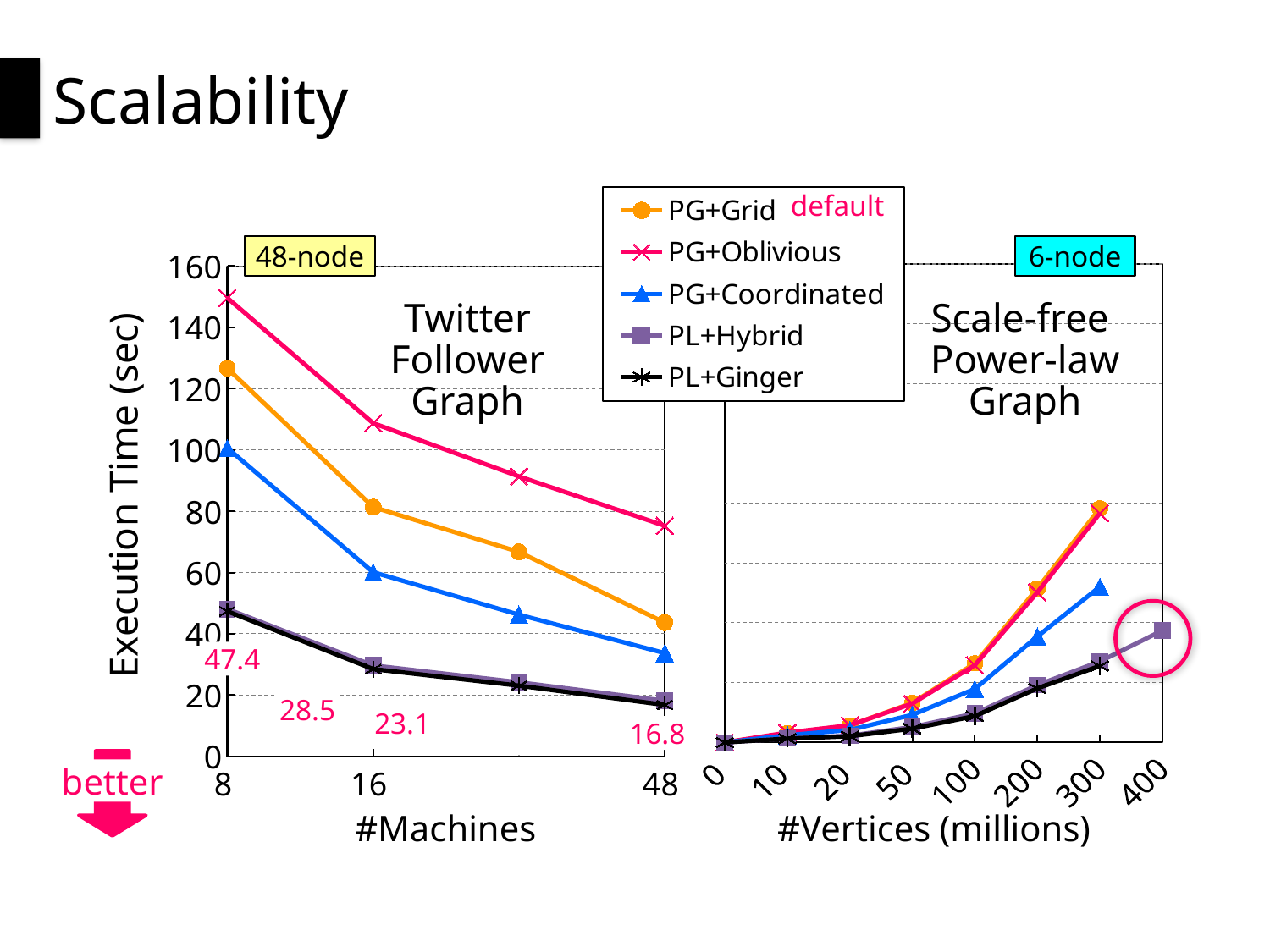
On the left chart (Twitter Follower Graph), is the value for PG+Oblivious at 8 machines greater or less than 140? greater On the left chart (Twitter Follower Graph), is the value for PG+Coordinated at 48 machines greater or less than 40? less On the left chart (Twitter Follower Graph), what value is labeled at 8 machines? 47.4 On the left chart (Twitter Follower Graph), what value is labeled at 16 machines? 28.5 On the right chart (Scale-free Power-law Graph), is the value for PG+Coordinated at 300 million vertices greater or less than 60? less Which series is marked as the default in the legend? PG+Grid What type of chart is the left chart (Twitter Follower Graph)? line chart On the left chart (Twitter Follower Graph), what is the difference between the labeled values at 8 machines and 48 machines? 30.6 On the left chart (Twitter Follower Graph), what value is labeled at 48 machines? 16.8 On the left chart (Twitter Follower Graph), which series has the highest execution time at 8 machines? PG+Oblivious On the right chart (Scale-free Power-law Graph), do execution times rise or fall as the number of vertices increases? rise How many series does the legend list? 5